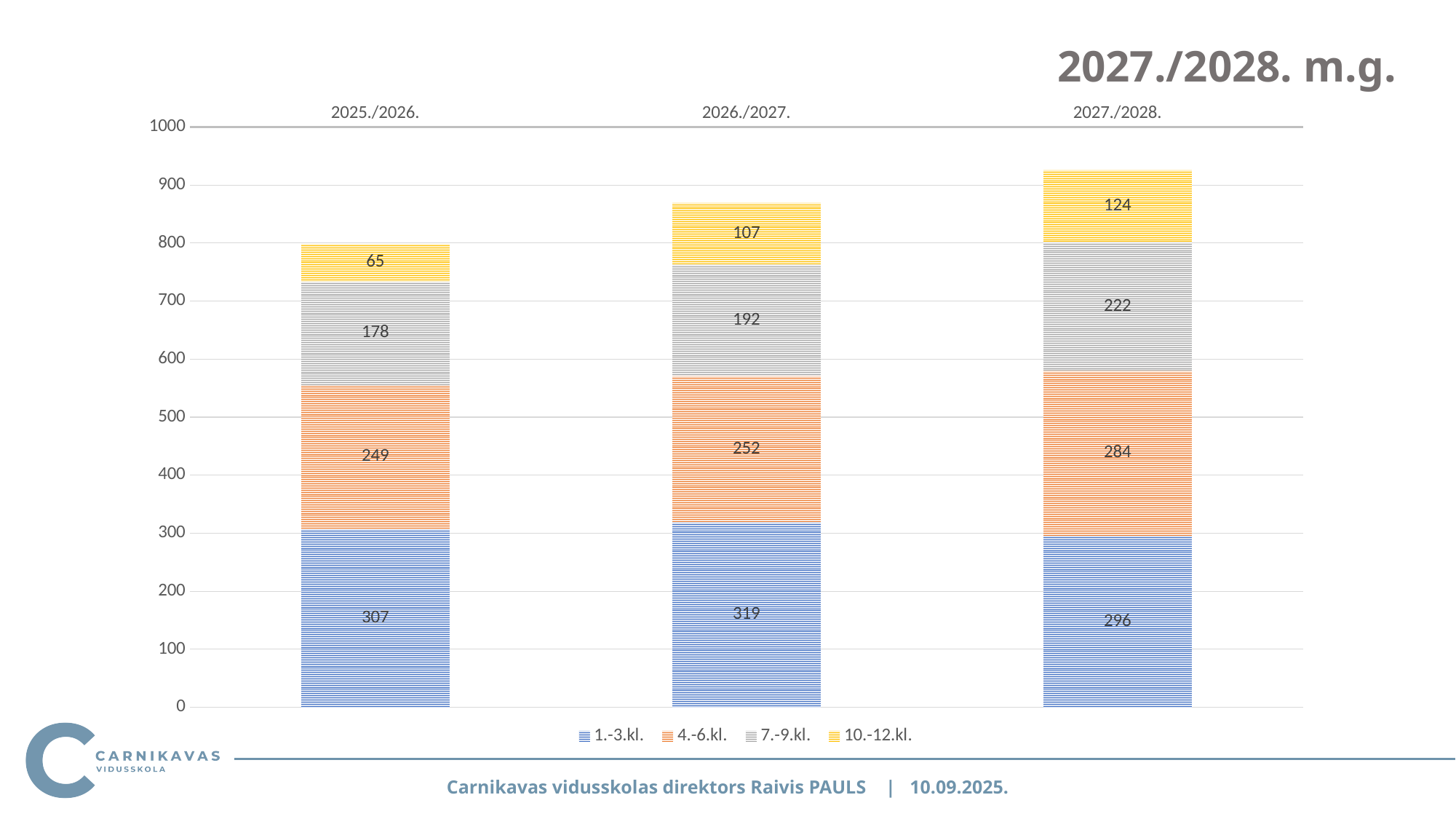
What is the total of the stacked bar for 2025./2026.? 799 Which school year has the lowest value for 10.-12.kl.? 2025./2026. What is the value for 1.-3.kl. in 2025./2026.? 307 What is the value for 10.-12.kl. in 2027./2028.? 124 How many school years are shown on the x axis? 3 How many series does the legend list? 4 Which school year has the highest value for 4.-6.kl.? 2027./2028. What is the difference between the 7.-9.kl. values for 2027./2028. and 2025./2026.? 44 Which is larger: the 1.-3.kl. value in 2026./2027. or in 2027./2028.? 2026./2027. What is the value for 7.-9.kl. in 2026./2027.? 192 What is the total of the stacked bar for 2026./2027.? 870 What kind of chart is shown on the slide? Stacked bar chart